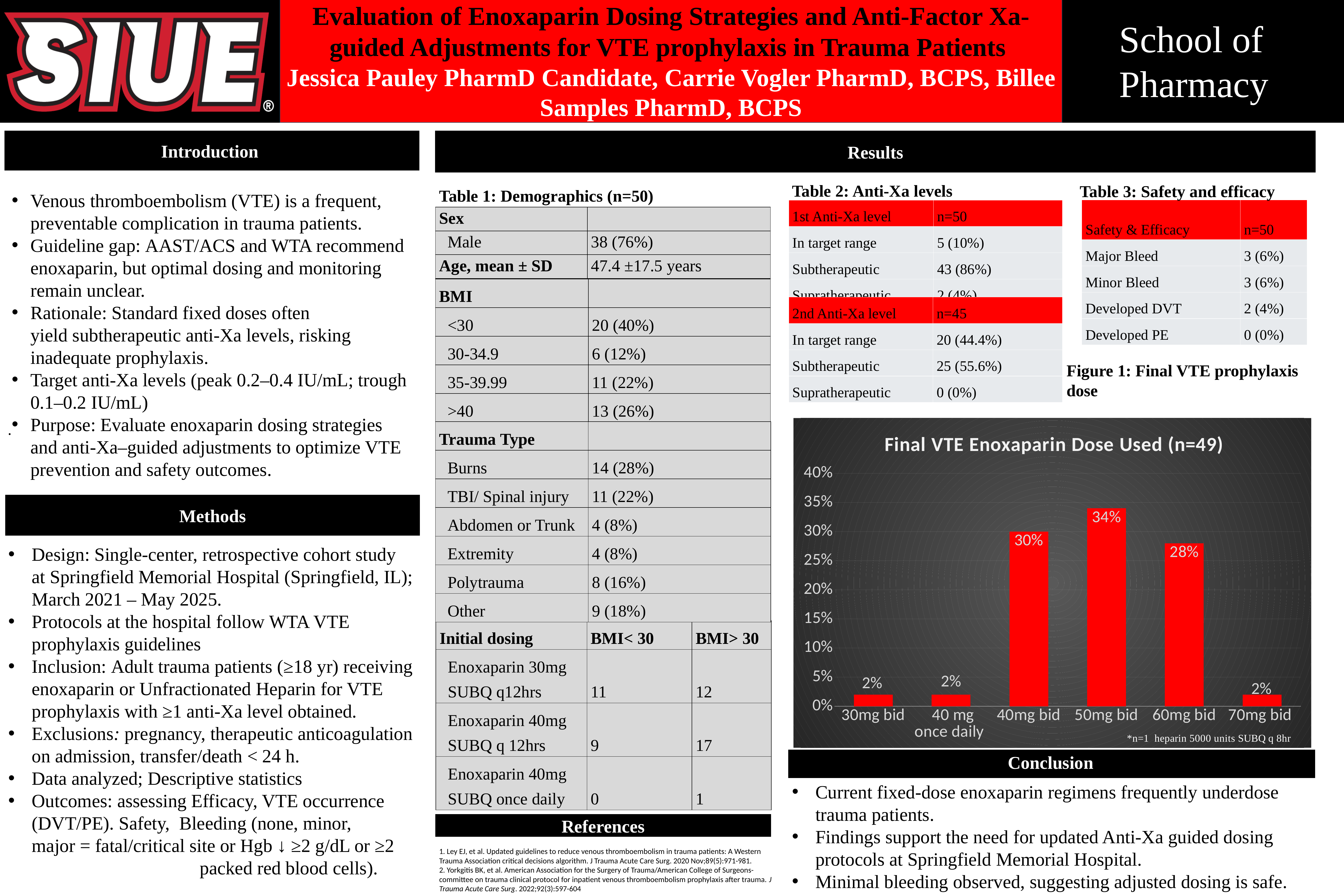
What is the value for 40mg bid in the Final VTE Enoxaparin Dose Used chart? 30% What is the value for 30mg bid in the Final VTE Enoxaparin Dose Used chart? 2% What is the value for 50mg bid in the Final VTE Enoxaparin Dose Used chart? 34% What is the title of the chart on the slide? Final VTE Enoxaparin Dose Used (n=49) Which dose category has the highest value in the Final VTE Enoxaparin Dose Used chart? 50mg bid What is the difference between the values for 40mg bid and 70mg bid in the Final VTE Enoxaparin Dose Used chart? 28% Is the value for 50mg bid in the Final VTE Enoxaparin Dose Used chart greater or less than 30%? greater In the Final VTE Enoxaparin Dose Used chart, which is larger: the value for 40mg bid or the value for 60mg bid? 40mg bid What is the difference between the values for 50mg bid and 60mg bid in the Final VTE Enoxaparin Dose Used chart? 6% What kind of chart is the Final VTE Enoxaparin Dose Used chart? bar chart What is the value for 60mg bid in the Final VTE Enoxaparin Dose Used chart? 28% How many dose categories are shown in the Final VTE Enoxaparin Dose Used chart? 6